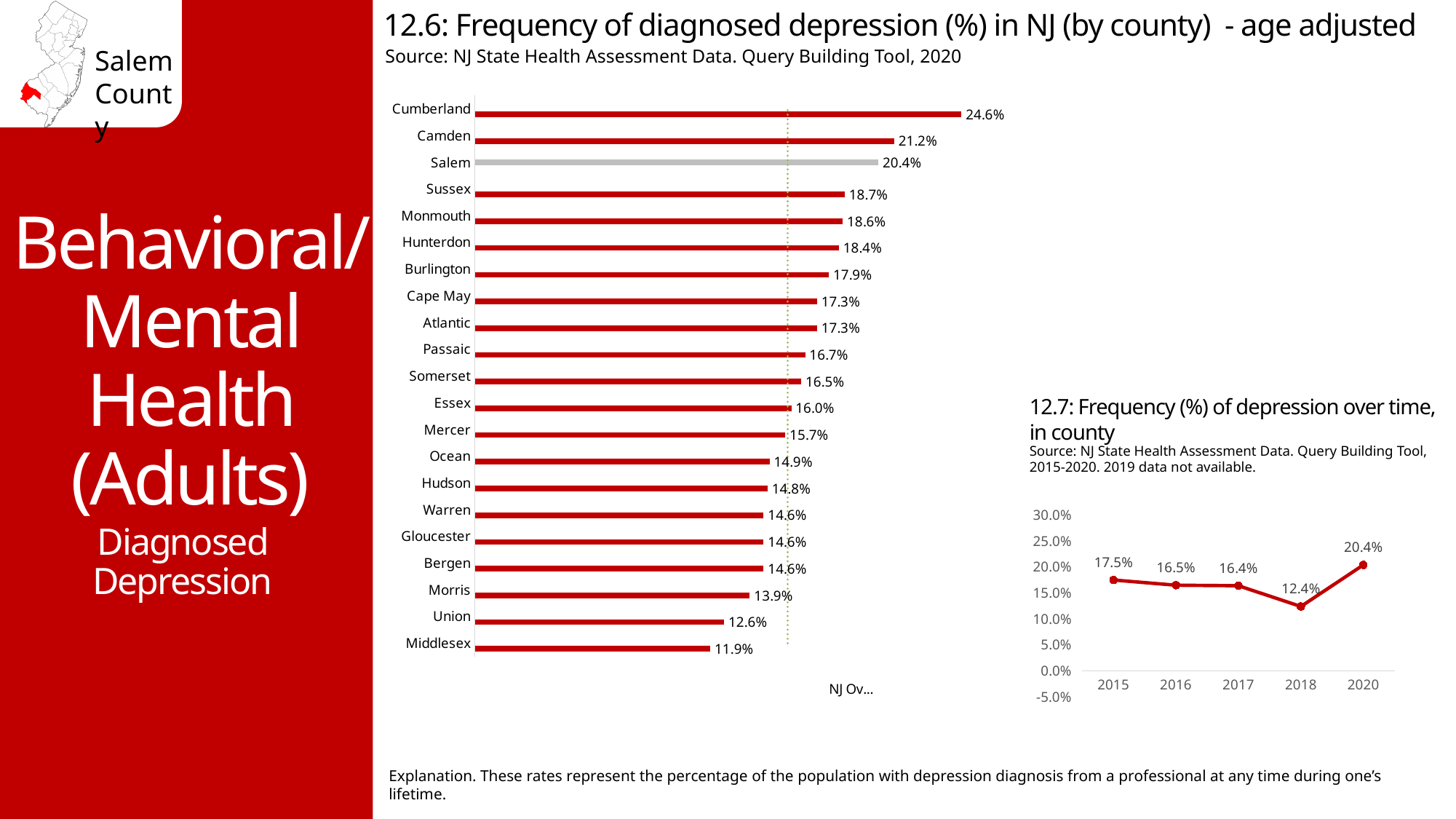
In the chart '12.6: Frequency of diagnosed depression (%) in NJ (by county) - age adjusted', which county has the highest value? Cumberland In the chart '12.6: Frequency of diagnosed depression (%) in NJ (by county) - age adjusted', what is the value for Salem? 20.4% In the chart '12.7: Frequency (%) of depression over time, in county', what is the value for 2018? 12.4% In the chart '12.6: Frequency of diagnosed depression (%) in NJ (by county) - age adjusted', which county has the lowest value? Middlesex In the chart '12.6: Frequency of diagnosed depression (%) in NJ (by county) - age adjusted', how many counties are shown? 21 In the chart '12.6: Frequency of diagnosed depression (%) in NJ (by county) - age adjusted', what is the difference between Cumberland and Camden? 3.4% In the chart '12.6: Frequency of diagnosed depression (%) in NJ (by county) - age adjusted', what is the value for Union? 12.6% What kind of chart is '12.6: Frequency of diagnosed depression (%) in NJ (by county) - age adjusted'? Bar chart In the chart '12.7: Frequency (%) of depression over time, in county', what is the difference between 2020 and 2018? 8.0% In the chart '12.7: Frequency (%) of depression over time, in county', which year has the highest value? 2020 In the chart '12.6: Frequency of diagnosed depression (%) in NJ (by county) - age adjusted', which is larger, Sussex or Hunterdon? Sussex What kind of chart is '12.7: Frequency (%) of depression over time, in county'? Line chart